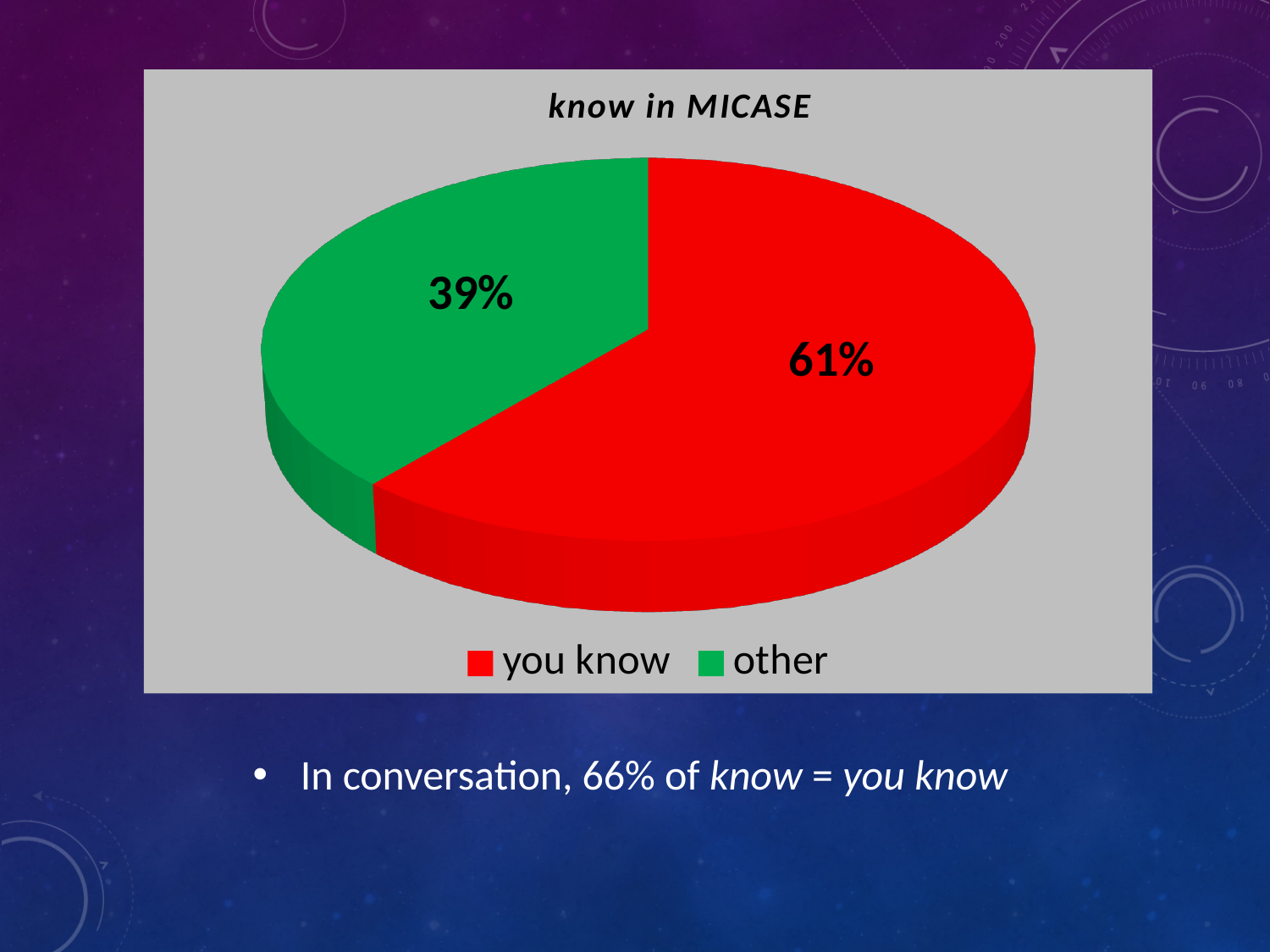
Which is larger, the "you know" slice or the "other" slice? you know What colour is the "other" slice in the pie chart? green What kind of chart is shown on the slide? pie chart What share of the pie does the "other" slice represent? 39% How many slices does the pie chart have? 2 How many entries does the legend list? 2 What share of the pie does the "you know" slice represent? 61% Which slice is the largest in the pie chart? you know What is the difference in percentage points between the "you know" slice and the "other" slice? 22 Which slice is the smallest in the pie chart? other What is the title of the chart? know in MICASE